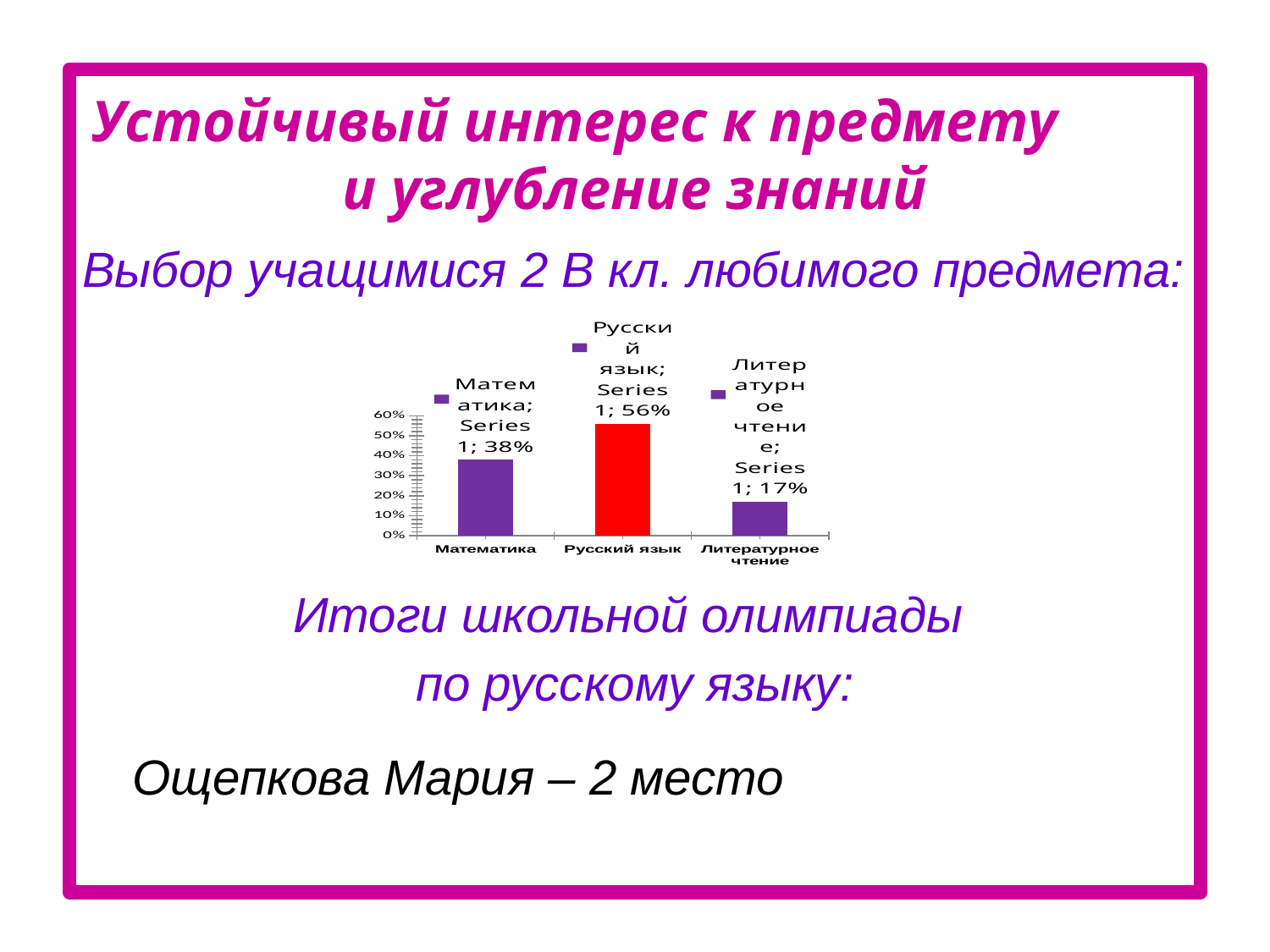
What colour is the bar for Русский язык? red Which is larger, the value for Математика or the value for Литературное чтение? Математика What type of chart is shown on the slide? bar chart What percentage of students chose Математика as their favourite subject? 38% What is the difference between the percentages for Математика and Литературное чтение? 21% Which subject has the highest percentage in the chart? Русский язык How many subjects (categories) are shown in the chart? 3 What percentage of students chose Литературное чтение as their favourite subject? 17% What is the difference between the percentages for Русский язык and Математика? 18% Is the value for Русский язык greater or less than 50%? greater What percentage of students chose Русский язык as their favourite subject? 56% Which subject has the lowest percentage in the chart? Литературное чтение